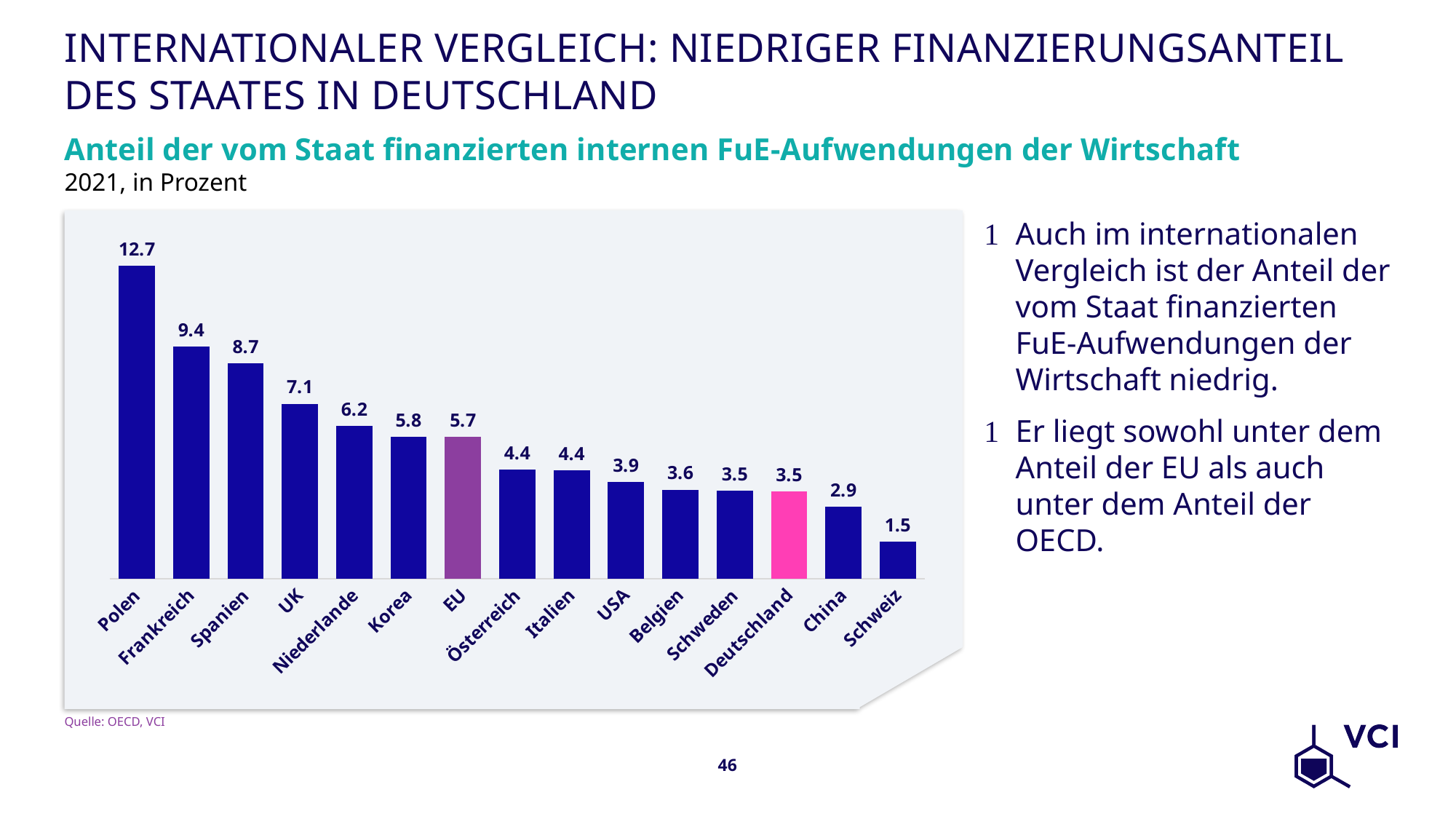
Which is larger, the value for Spanien or the value for UK? Spanien How many categories are shown in the chart? 15 What is the difference between the values for Polen and Schweiz? 11.2 Which country has the lowest value? Schweiz What is the difference between the values for EU and Deutschland? 2.2 Do the values rise or fall from left to right along the x axis? Fall What is the value for EU? 5.7 Which country has the highest value? Polen What is the value for Frankreich? 9.4 Which bar is highlighted in pink? Deutschland What is the value for Deutschland? 3.5 What kind of chart is shown on the slide? Bar chart